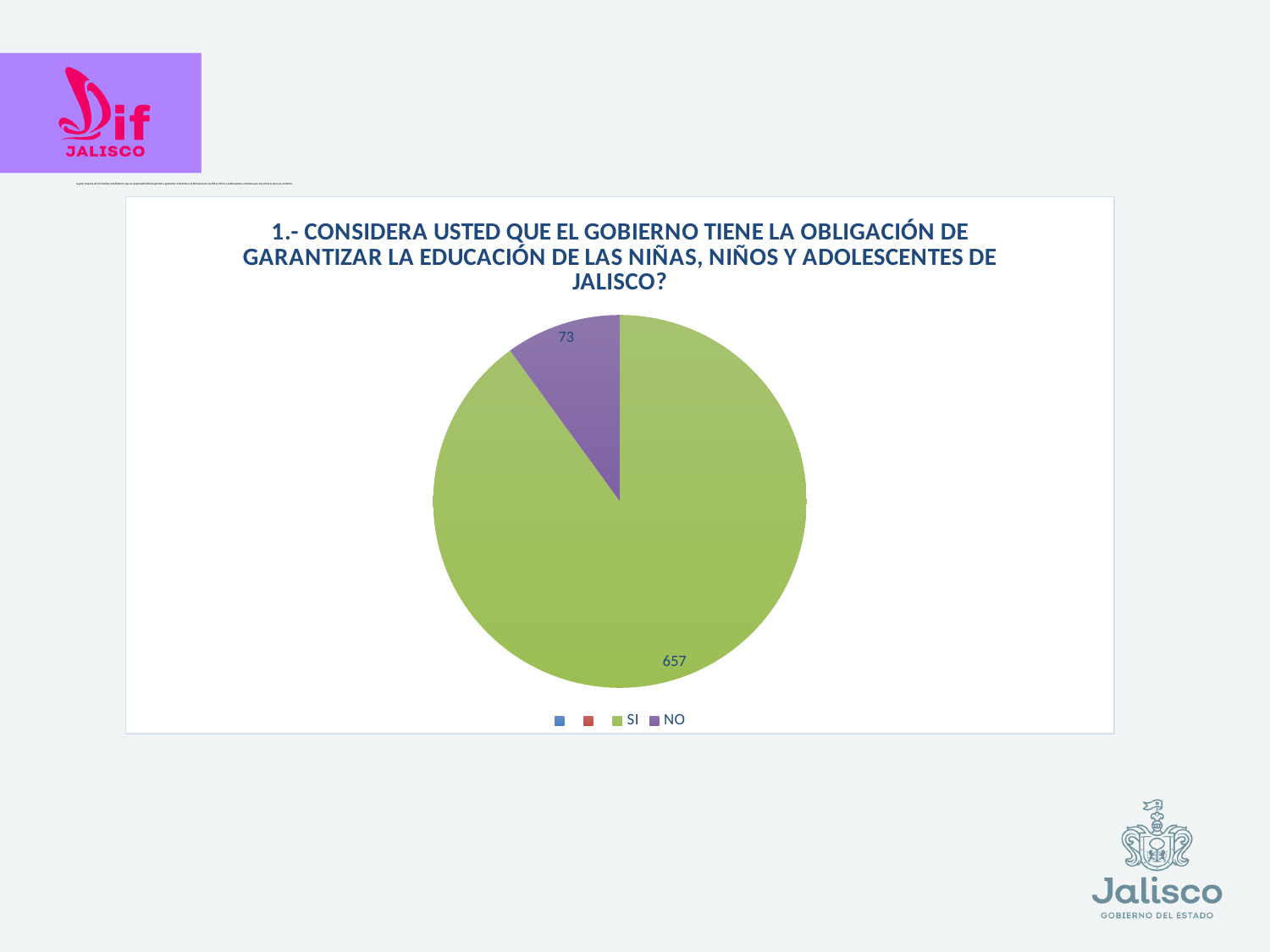
What share of the pie does the NO slice represent? 10% Which category has the largest slice in the pie chart? SI What is the total of the SI and NO values shown in the pie chart? 730 What is the difference between the SI and NO values? 584 How many slices are visible in the pie chart? 2 Which is larger, the value for SI or the value for NO? SI What kind of chart is shown on the slide? pie chart What colour is the SI slice in the pie chart? green What share of the pie does the SI slice represent? 90% What is the value for SI in the pie chart? 657 Which category has the smallest slice in the pie chart? NO What is the value for NO in the pie chart? 73